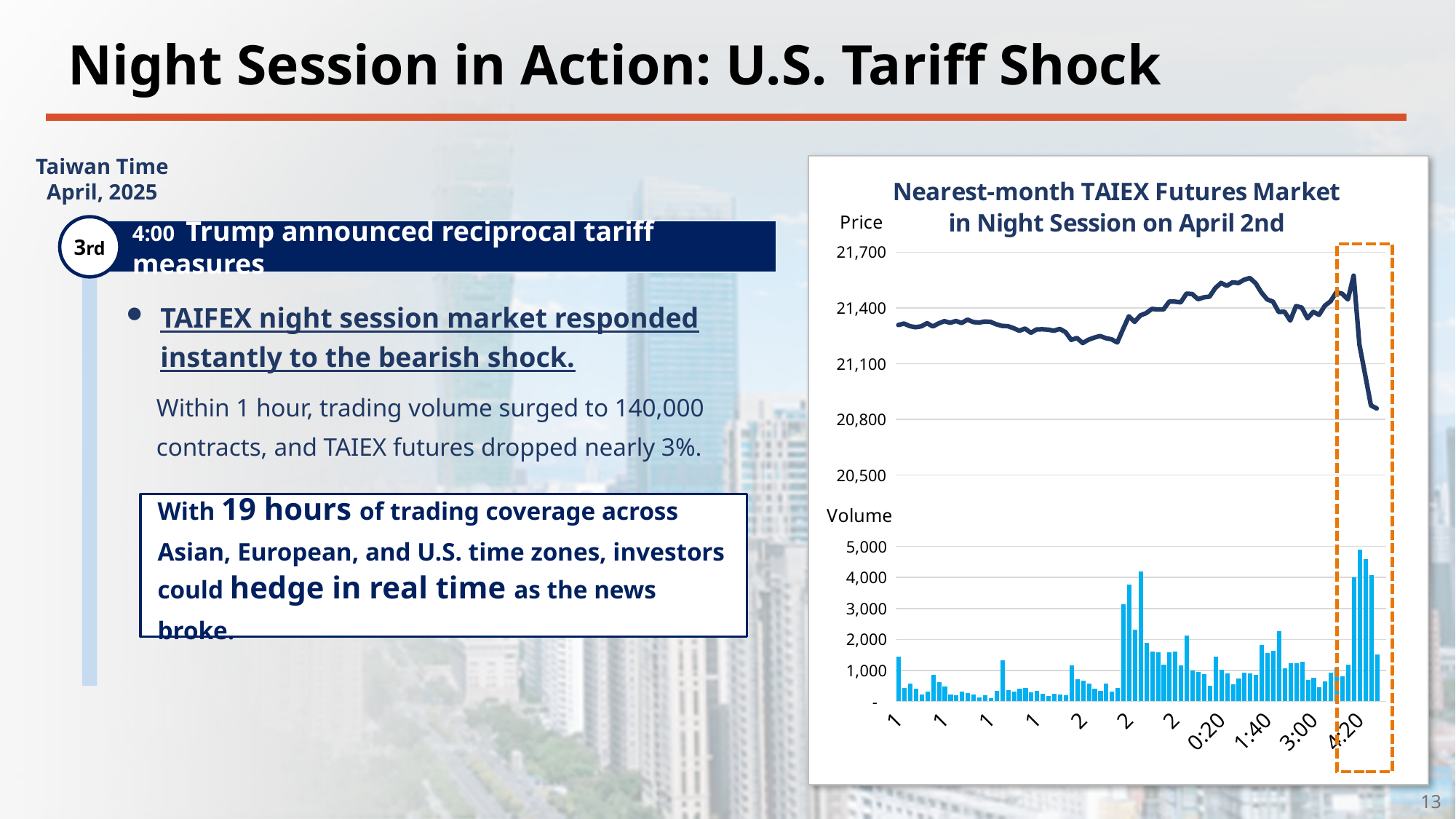
Is the lowest price in the series greater or less than 21,100? less Is the peak price reached just before the sharp drop greater or less than 21,400? greater Does the price rise or fall in the highlighted region around 4:20? fall Is the tallest volume bar in the highlighted region around 4:20 greater or less than 3,000? greater What is the highest tick shown on the Volume axis? 5,000 What kind of chart is the Price panel at the top of the chart? line chart What kind of chart is the Volume panel at the bottom of the chart? bar chart What is the title of the chart on the slide? Nearest-month TAIEX Futures Market in Night Session on April 2nd